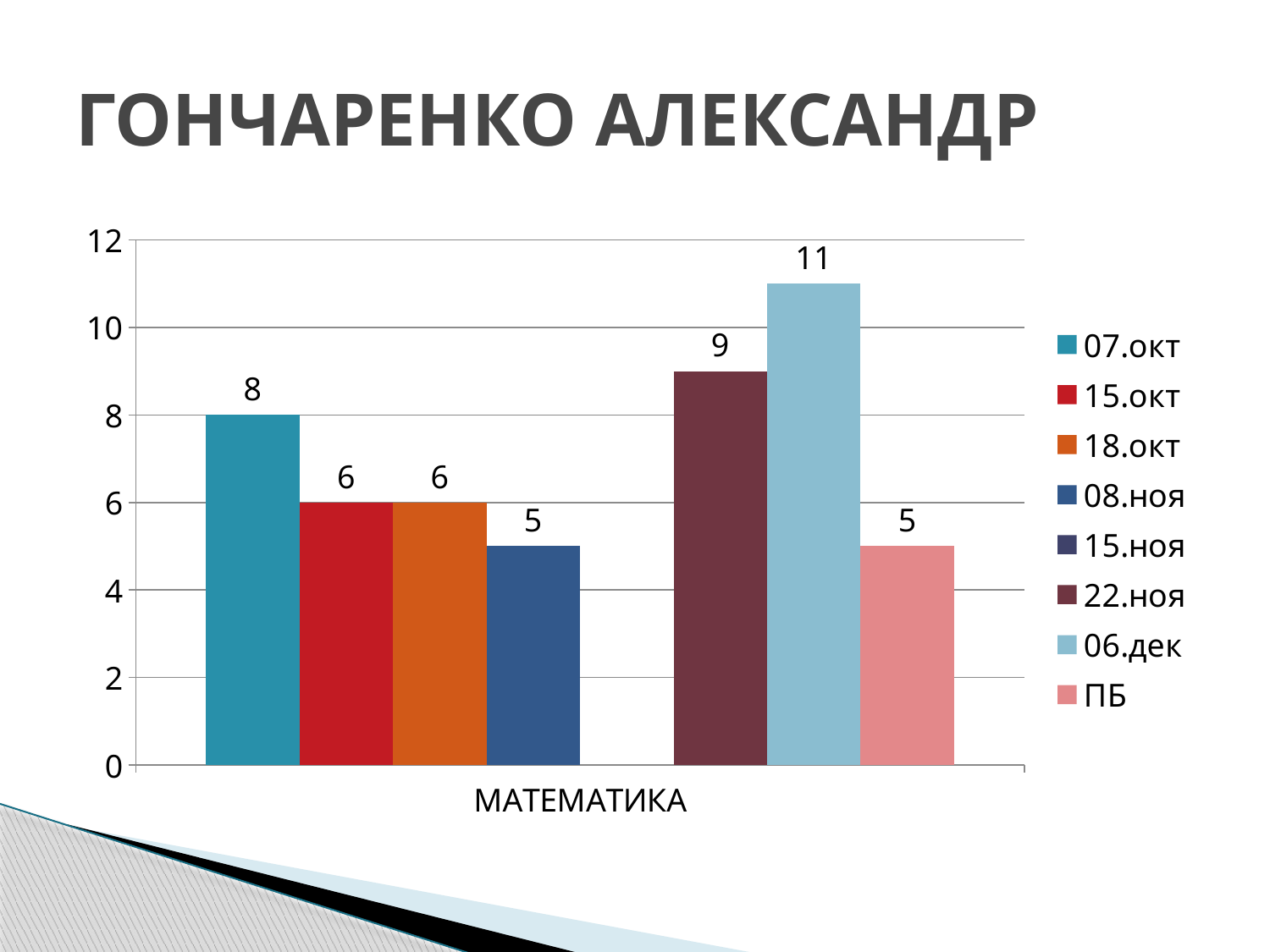
Which series has the highest value? 06.дек What is the value for ПБ? 5 Which is larger, the value for 22.ноя or the value for 07.окт? 22.ноя What is the value for 06.дек? 11 What is the difference between the values for 22.ноя and 15.окт? 3 What is the category label shown on the x axis? МАТЕМАТИКА What is the value for 07.окт in the МАТЕМАТИКА chart? 8 What is the value for 22.ноя? 9 How many series does the legend list? 8 What is the difference between the values for 06.дек and 07.окт? 3 What is the lowest value shown by any bar in the chart? 5 What kind of chart is shown on the slide? Bar chart